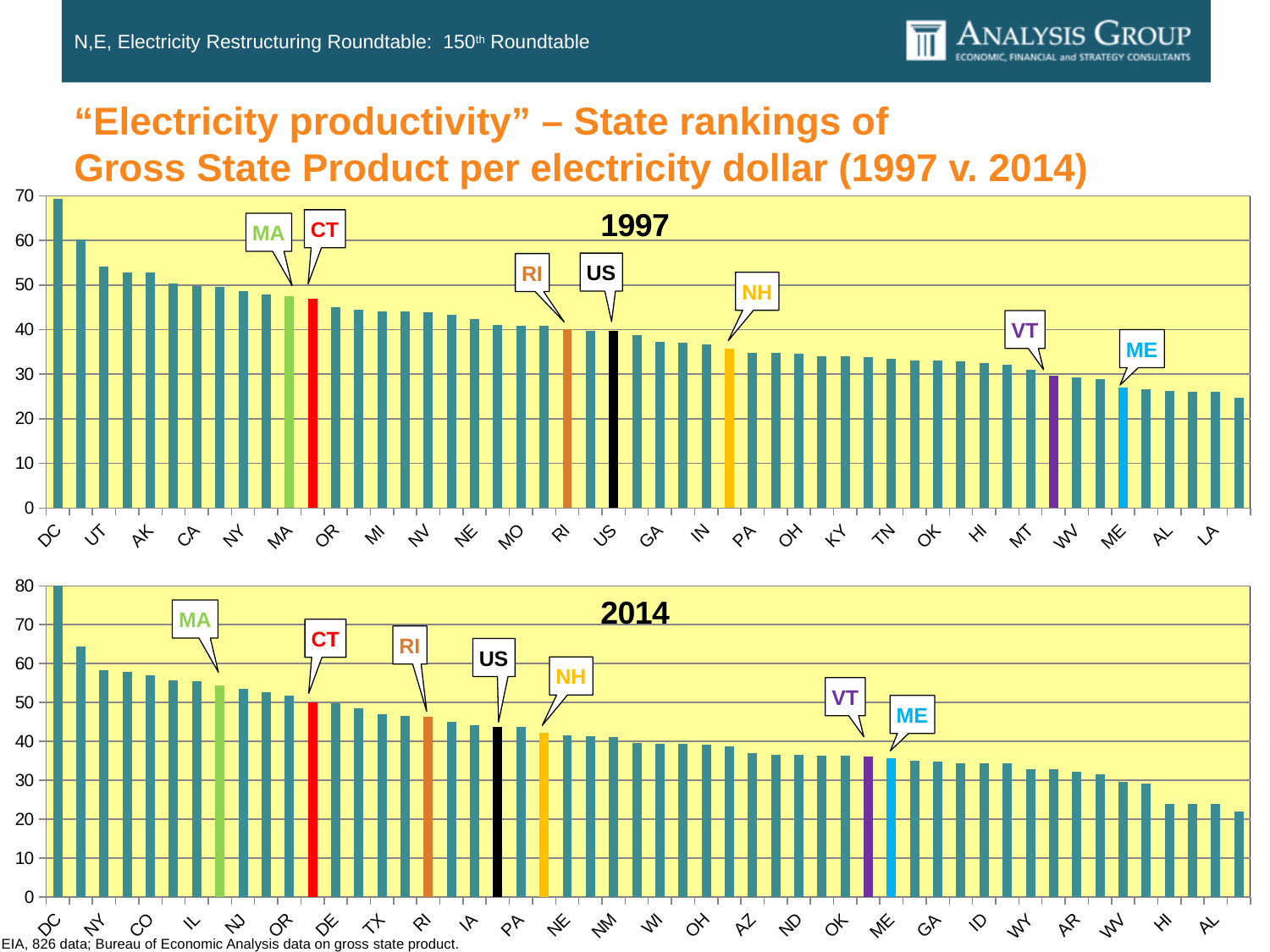
In the 2014 chart, which labeled state has the lowest value? AL In the 1997 chart, is the value for ME greater or less than 30? less In the 2014 chart, do the values rise or fall from left to right along the x axis? fall In the 2014 chart, is the value for MA greater or less than 50? greater Which two years are compared in the charts on this slide? 1997 and 2014 What kind of chart is the 1997 chart? bar chart In the 1997 chart, which labeled state has the lowest value? LA In the 2014 chart, which state has the highest value? DC In the 1997 chart, which is larger, the value for MA or the value for ME? MA In the 2014 chart, is the value for VT greater or less than 40? less In the 1997 chart, which state has the highest value? DC